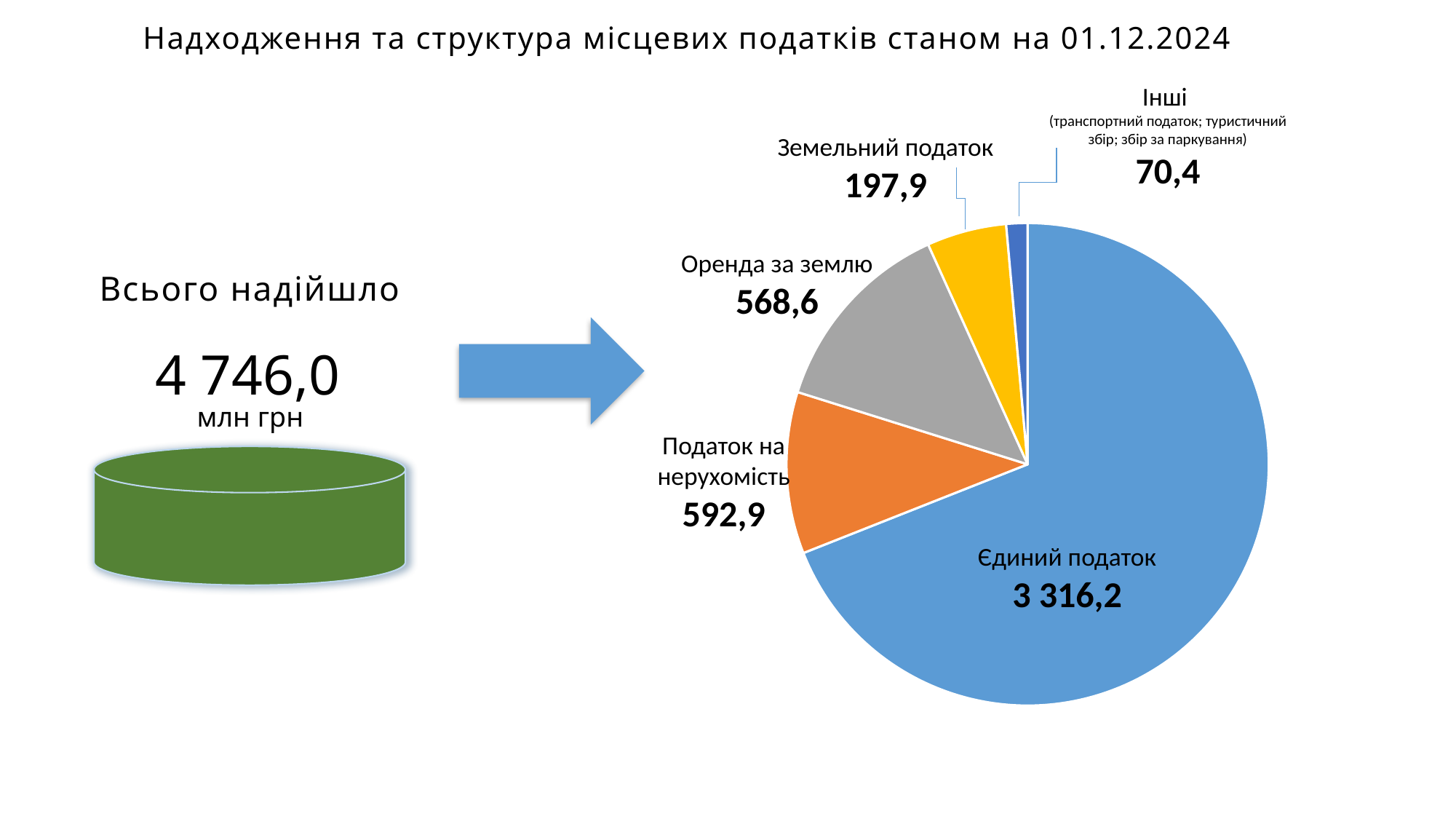
Which category has the smallest slice in the pie chart? Інші What is the value for Земельний податок in the pie chart? 197,9 How many slices does the pie chart have? 5 What is the value for Інші (транспортний податок; туристичний збір; збір за паркування) in the pie chart? 70,4 What is the value for Єдиний податок in the pie chart? 3 316,2 What is the value for Податок на нерухомість in the pie chart? 592,9 What is the difference between Податок на нерухомість and Оренда за землю? 24,3 Which category has the largest slice in the pie chart? Єдиний податок What is the difference between Земельний податок and Інші? 127,5 Which is larger, Податок на нерухомість or Оренда за землю? Податок на нерухомість What type of chart is shown on the slide? Pie chart What is the value for Оренда за землю in the pie chart? 568,6